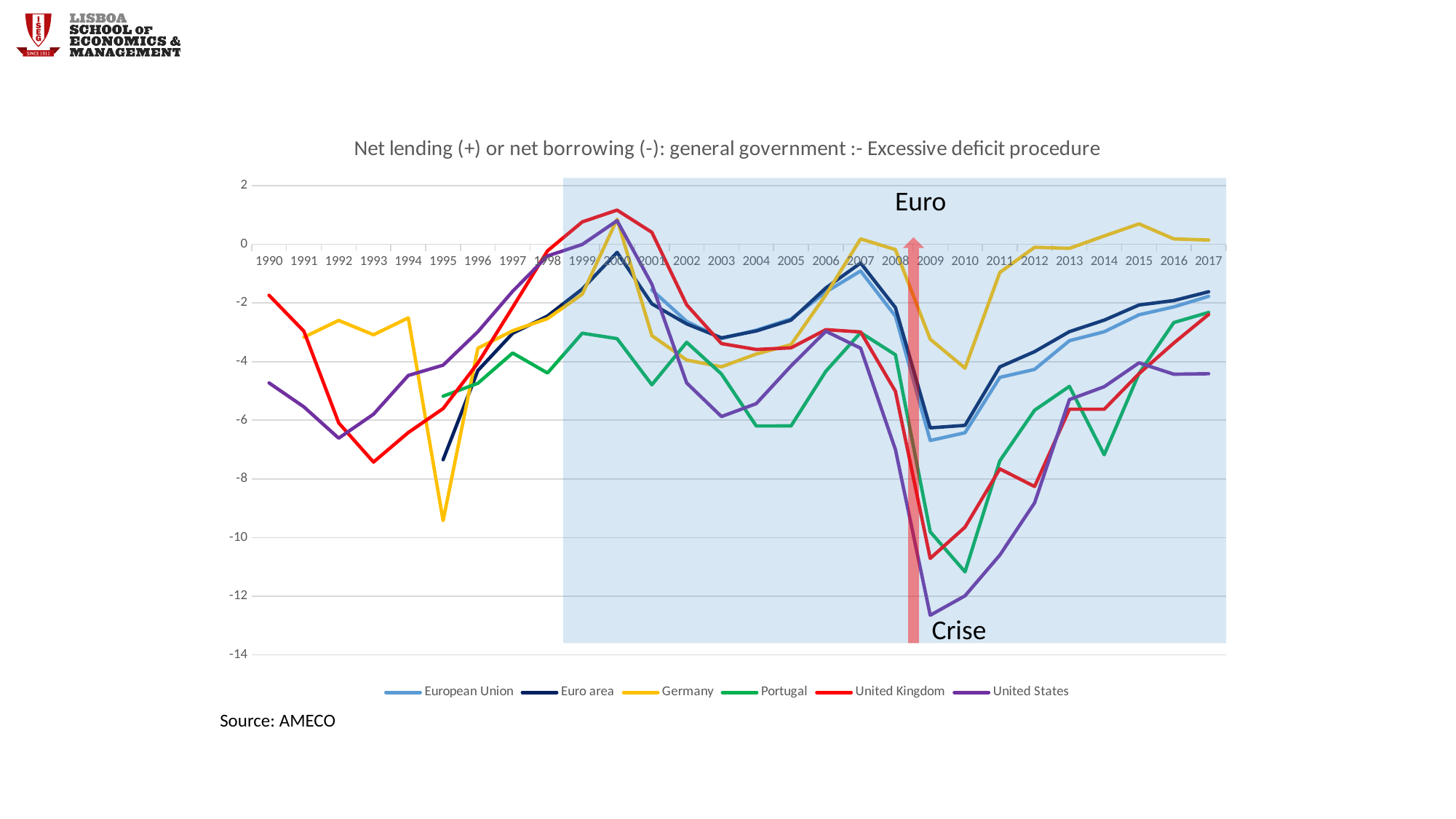
Which series has the lowest value in 2009? United States Do the values for the United States rise or fall from 2009 to 2015? rise What is the source cited below the chart? AMECO How many series does the legend list? 6 Is the value for the United States in 2009 greater or less than -12? less What kind of chart is shown on the slide? Line chart How many years are shown along the x axis? 28 Is the value for the United Kingdom in 2000 greater or less than 0? greater Which series has the highest value in 2015? Germany Is the value for Portugal in 2010 greater or less than -10? less In 2007, which is larger: the value for Germany or the value for Portugal? Germany